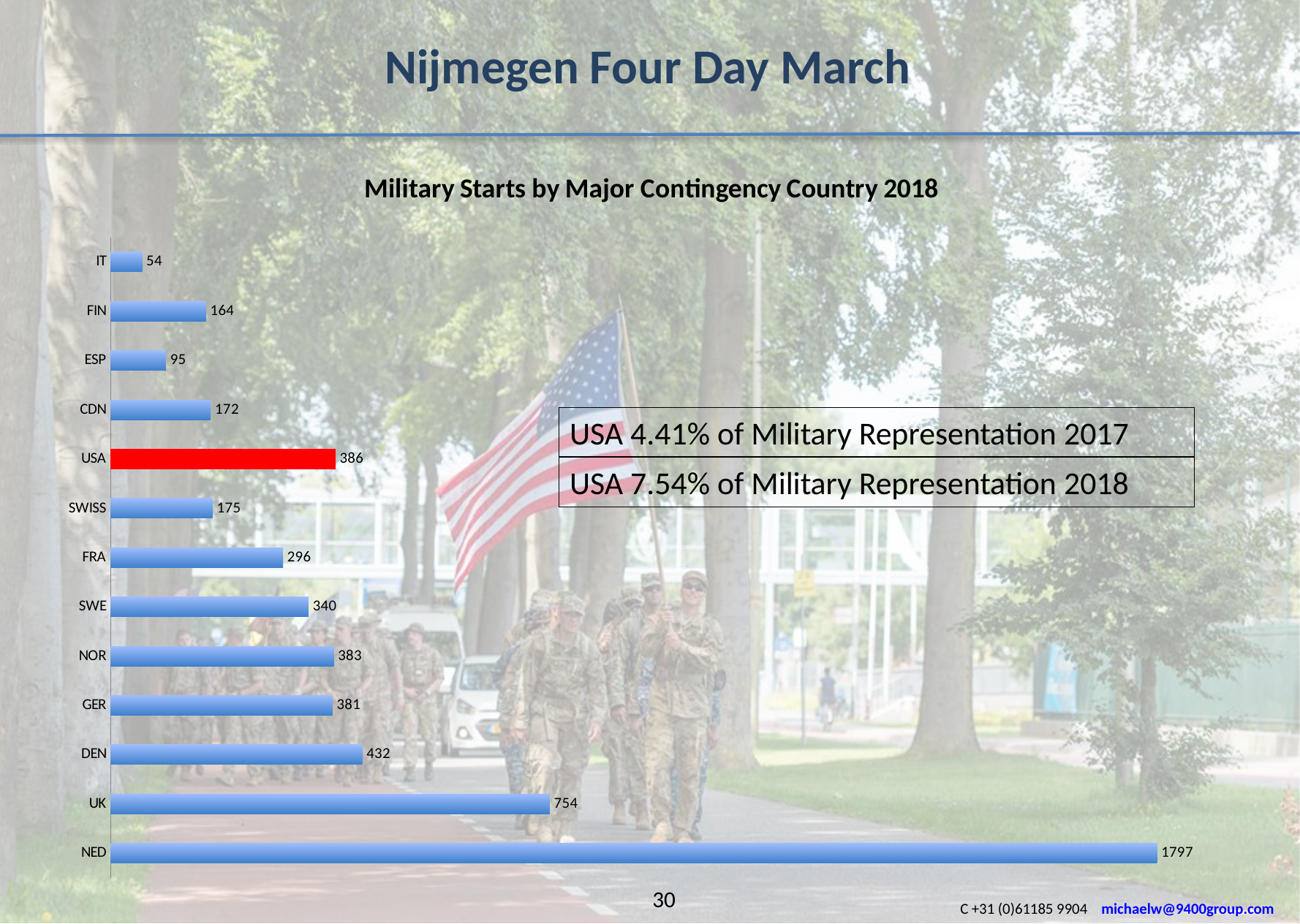
Which country's bar is coloured red in the chart? USA What is the difference between the values for UK and DEN? 322 Which country has the lowest number of military starts in the chart? IT How many countries are shown in the chart? 13 What is the difference between the values for USA and CDN? 214 What is the value for USA in the Military Starts by Major Contingency Country 2018 chart? 386 What is the value for FIN in the chart? 164 What kind of chart is shown on the slide? Bar chart Which country has the highest number of military starts in the chart? NED What is the value for NED in the chart? 1797 Which is larger, the value for SWE or the value for FRA? SWE What is the title of the chart? Military Starts by Major Contingency Country 2018